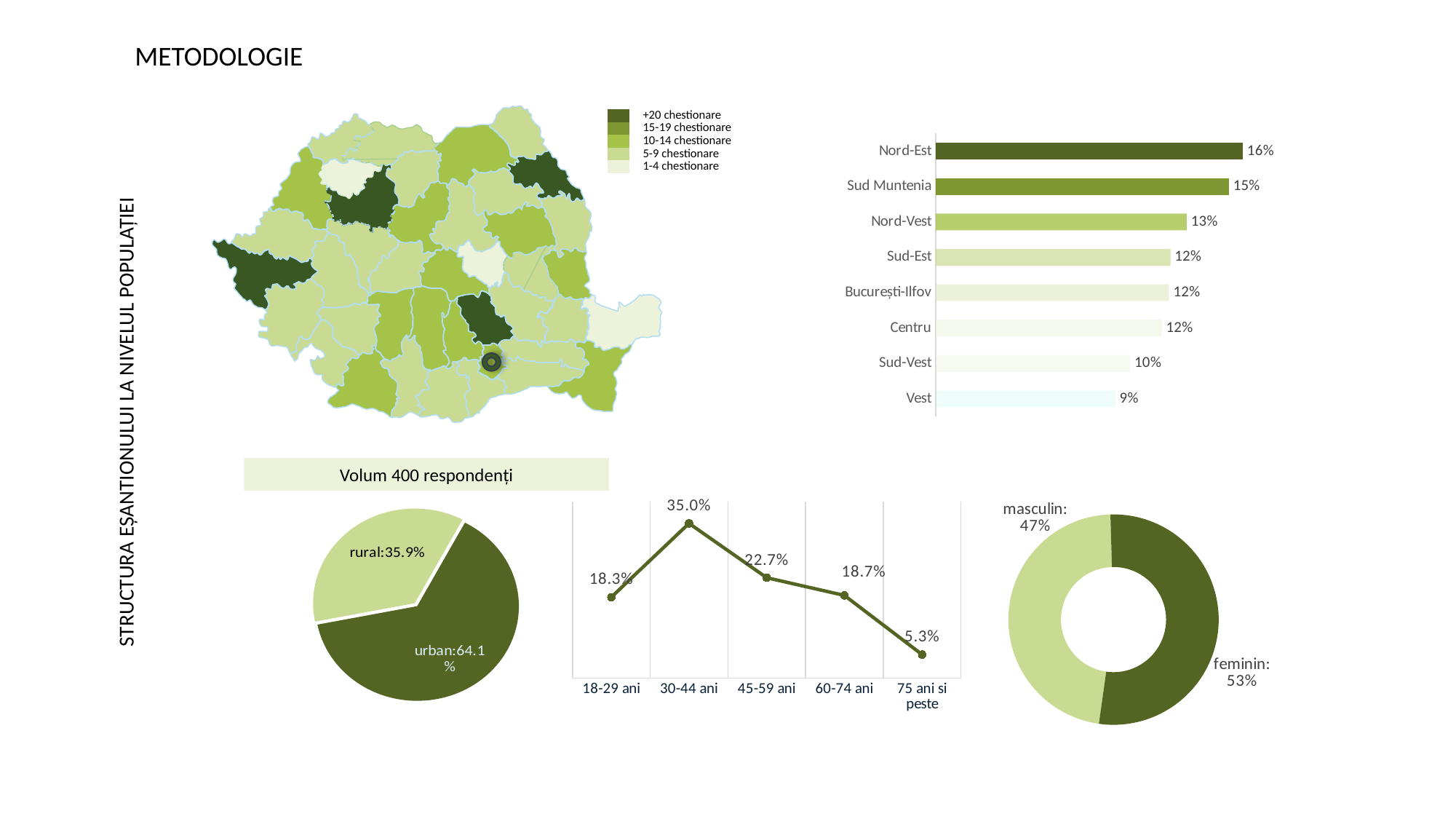
In the horizontal bar chart of regions at the top right, which region has the lowest value? Vest What kind of chart is the gender chart at the bottom right? Donut chart In the line chart of age groups at the bottom centre, what is the difference between 45-59 ani and 75 ani si peste? 17.4% In the line chart of age groups at the bottom centre, what is the value for 60-74 ani? 18.7% In the horizontal bar chart of regions at the top right, how many regions are shown? 8 In the line chart of age groups at the bottom centre, which age group has the highest value? 30-44 ani In the horizontal bar chart of regions at the top right, what is the difference between Sud Muntenia and Sud-Vest? 5% In the horizontal bar chart of regions at the top right, which is larger, Nord-Vest or Sud-Est? Nord-Vest In the pie chart at the bottom left, which slice is larger, urban or rural? urban In the donut chart at the bottom right, what is the share for feminin? 53% In the pie chart at the bottom left, what is the share for rural? 35.9% In the horizontal bar chart of regions at the top right, what is the value for Nord-Est? 16%